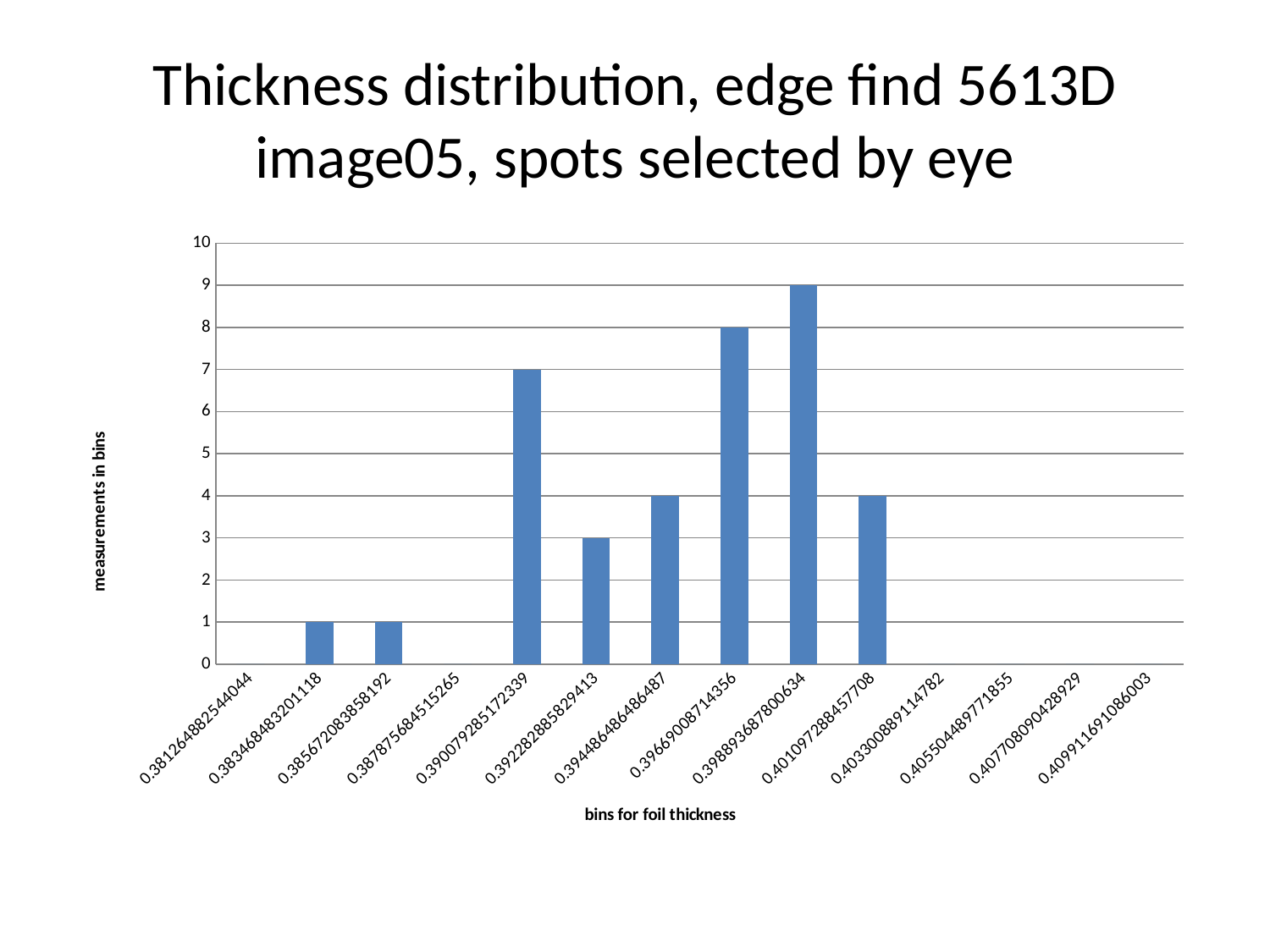
What kind of chart is shown on the slide? bar chart What is the number of measurements in the bin 0.398893687800634? 9 What is the number of measurements in the bin 0.392282885829413? 3 What is the difference in measurements between the bin 0.398893687800634 and the bin 0.39669008714356? 1 Which bin has more measurements, 0.394486486486487 or 0.392282885829413? 0.394486486486487 Which bin has the highest number of measurements? 0.398893687800634 What is the number of measurements in the bin 0.383468483201118? 1 What is the label of the x axis? bins for foil thickness Is the value for the bin 0.39669008714356 greater or less than 5? greater How many bins are shown along the x axis? 14 What is the number of measurements in the bin 0.390079285172339? 7 What is the label of the y axis? measurements in bins